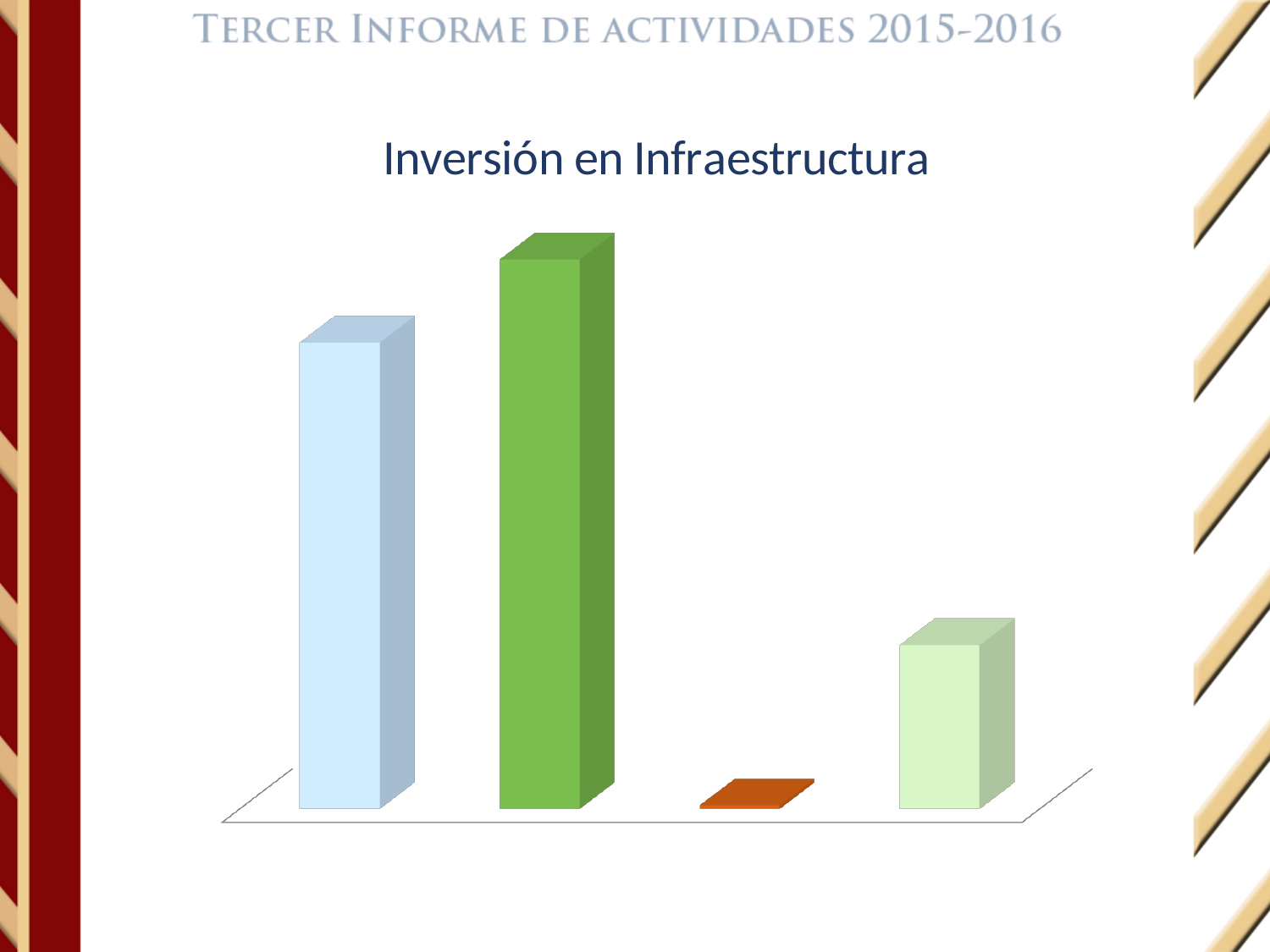
What is the title of the chart? Inversión en Infraestructura Which is shorter, the orange bar or the light green bar? The orange bar How many bars are plotted in the chart? 4 What kind of chart is shown on the slide? Bar chart Which is taller, the first bar from the left or the fourth bar from the left? The first bar Which is taller, the light blue bar or the dark green bar? The dark green bar Which bar is the shortest in the chart, by its position from the left? The third bar What colour is the tallest bar in the chart? Green Which bar is the tallest in the chart, by its position from the left? The second bar